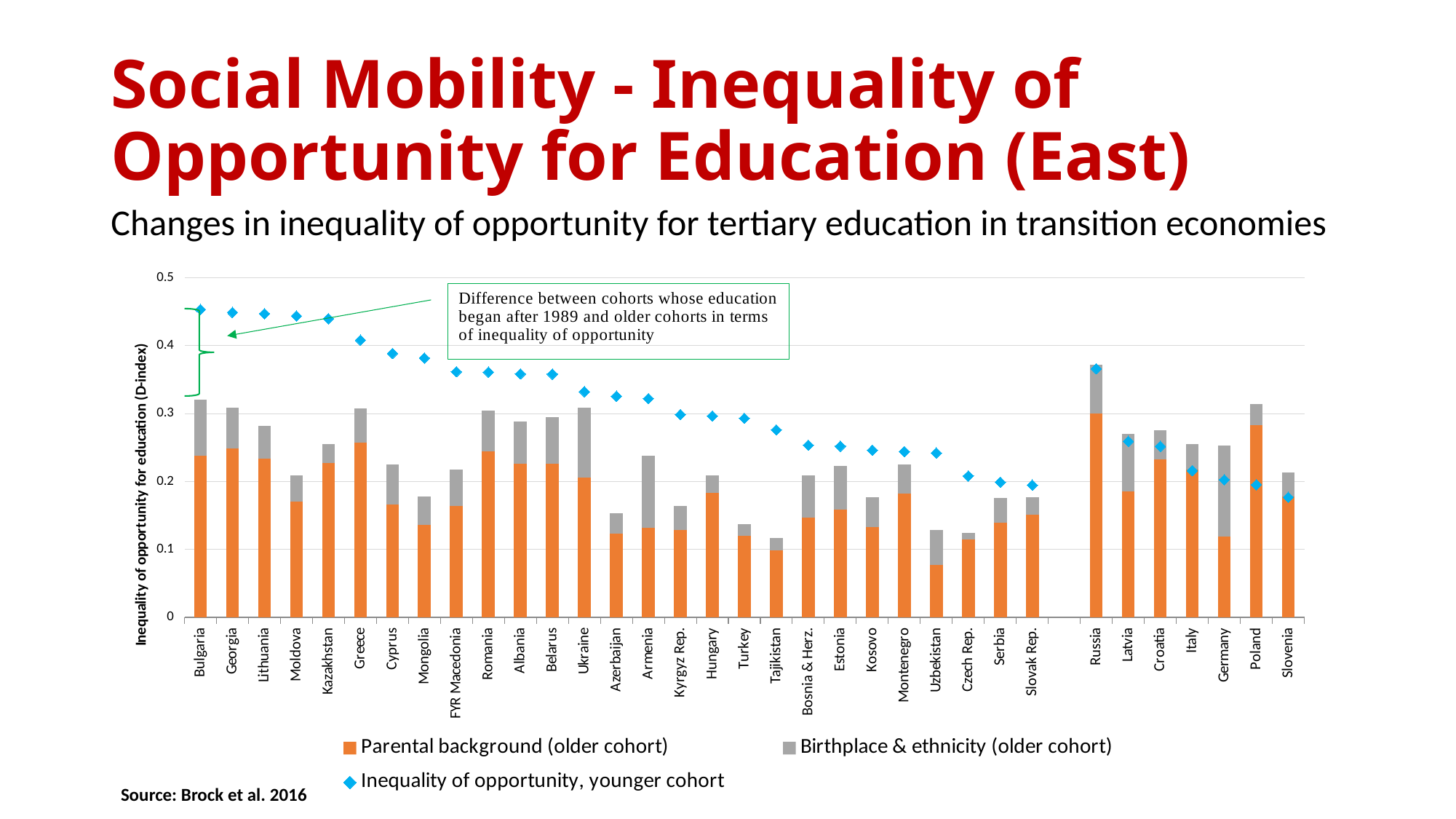
Is the value for Parental background (older cohort) for Germany greater or less than 0.2? less Which country has the lowest value for Inequality of opportunity, younger cohort? Slovenia Which country has the highest total stacked bar (older cohort)? Russia What is the label of the y axis? Inequality of opportunity for education (D-index) Is the value for Inequality of opportunity, younger cohort for Russia greater or less than 0.3? greater How many series does the legend list? 3 Is the value for Inequality of opportunity, younger cohort for Bulgaria greater or less than 0.4? greater What kind of chart is this? Stacked bar chart with diamond markers How many countries are shown on the x axis? 34 Do the Inequality of opportunity, younger cohort values rise or fall from Bulgaria to Slovak Rep.? fall Which is larger, the Parental background (older cohort) value for Russia or for Bulgaria? Russia